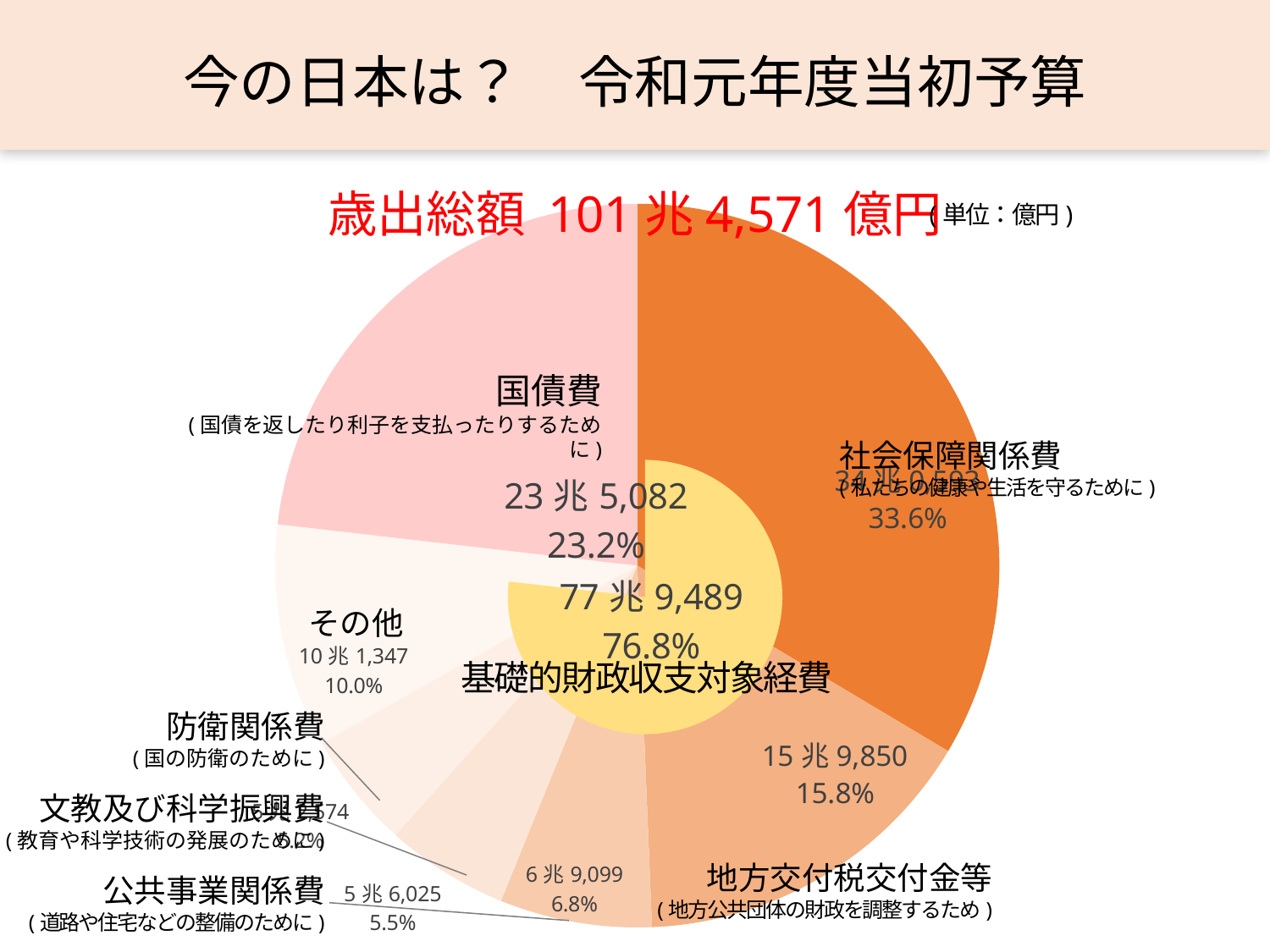
What share of the budget does 国債費 account for? 23.2% Which is larger, 国債費 or 地方交付税交付金等? 国債費 What is the total expenditure (歳出総額) shown above the chart? 101 兆 4,571 億円 What kind of chart is shown on the slide? pie chart What is the value shown for その他? 10 兆 1,347 What is the value shown for 国債費? 23 兆 5,082 What is the value shown for 地方交付税交付金等? 15 兆 9,850 Which category has the largest share of the pie? 社会保障関係費 What is the difference in percentage points between the share of 国債費 (23.2%) and 地方交付税交付金等 (15.8%)? 7.4% What share is shown for 基礎的財政収支対象経費 in the inner pie? 76.8% What share of the budget does 社会保障関係費 account for? 33.6%